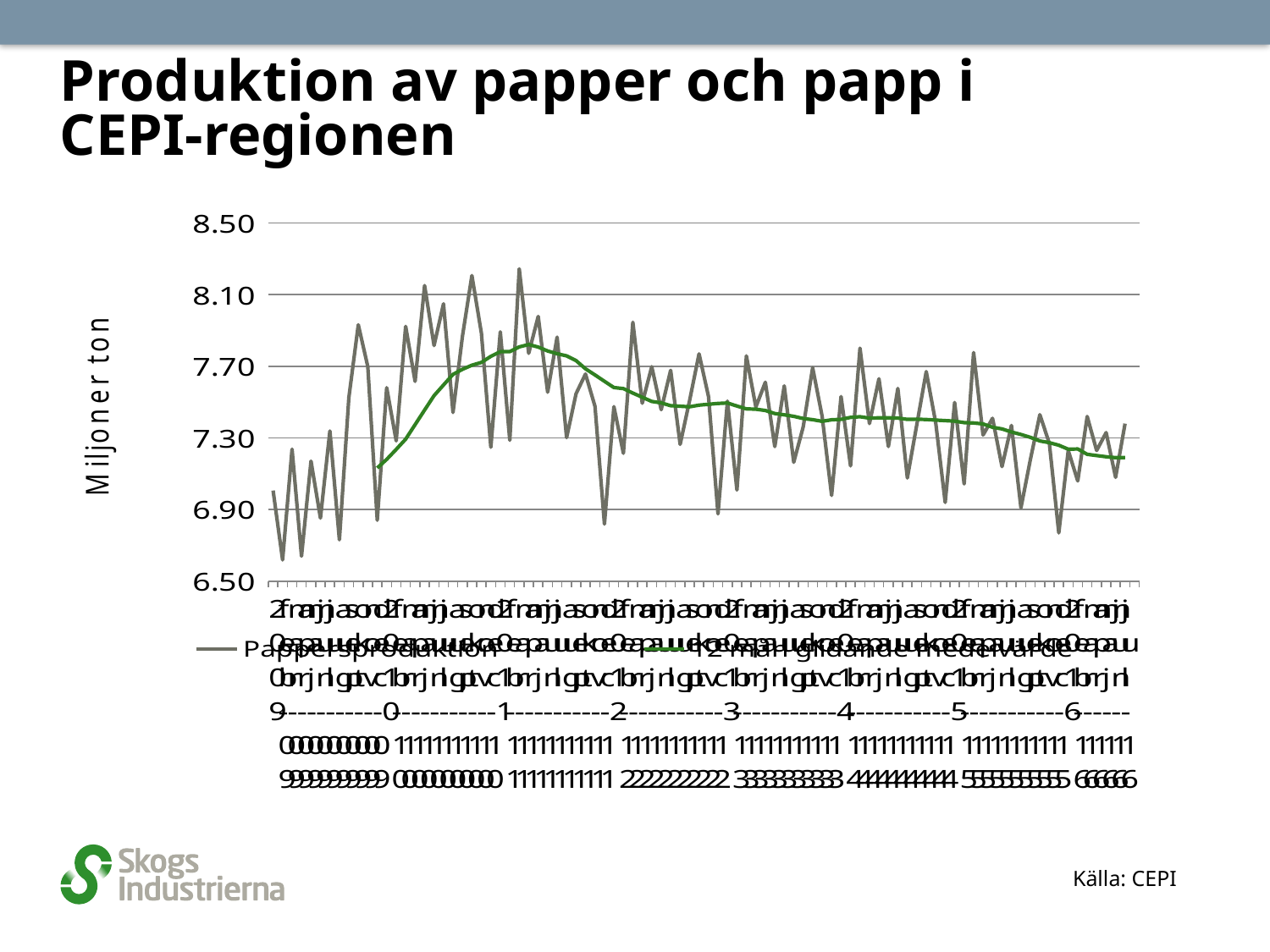
What unit is shown on the y-axis title? Miljoner ton Is the lowest point of the 12 mån glidande medelvärde line greater or less than 6.90? greater From its peak around 2011 to the end of the chart, does the 12 mån glidande medelvärde line rise or fall? fall Is the highest point of the 12 mån glidande medelvärde line greater or less than 8.10? less What is the highest value shown on the y-axis? 8.50 What kind of chart is shown on the slide? Line chart Is the highest point of the Pappersproduktion line greater or less than 8.10? greater What are the two series named in the legend? Pappersproduktion and 12 mån glidande medelvärde How many series does the legend list? 2 Which series shows larger month-to-month fluctuations, Pappersproduktion or 12 mån glidande medelvärde? Pappersproduktion